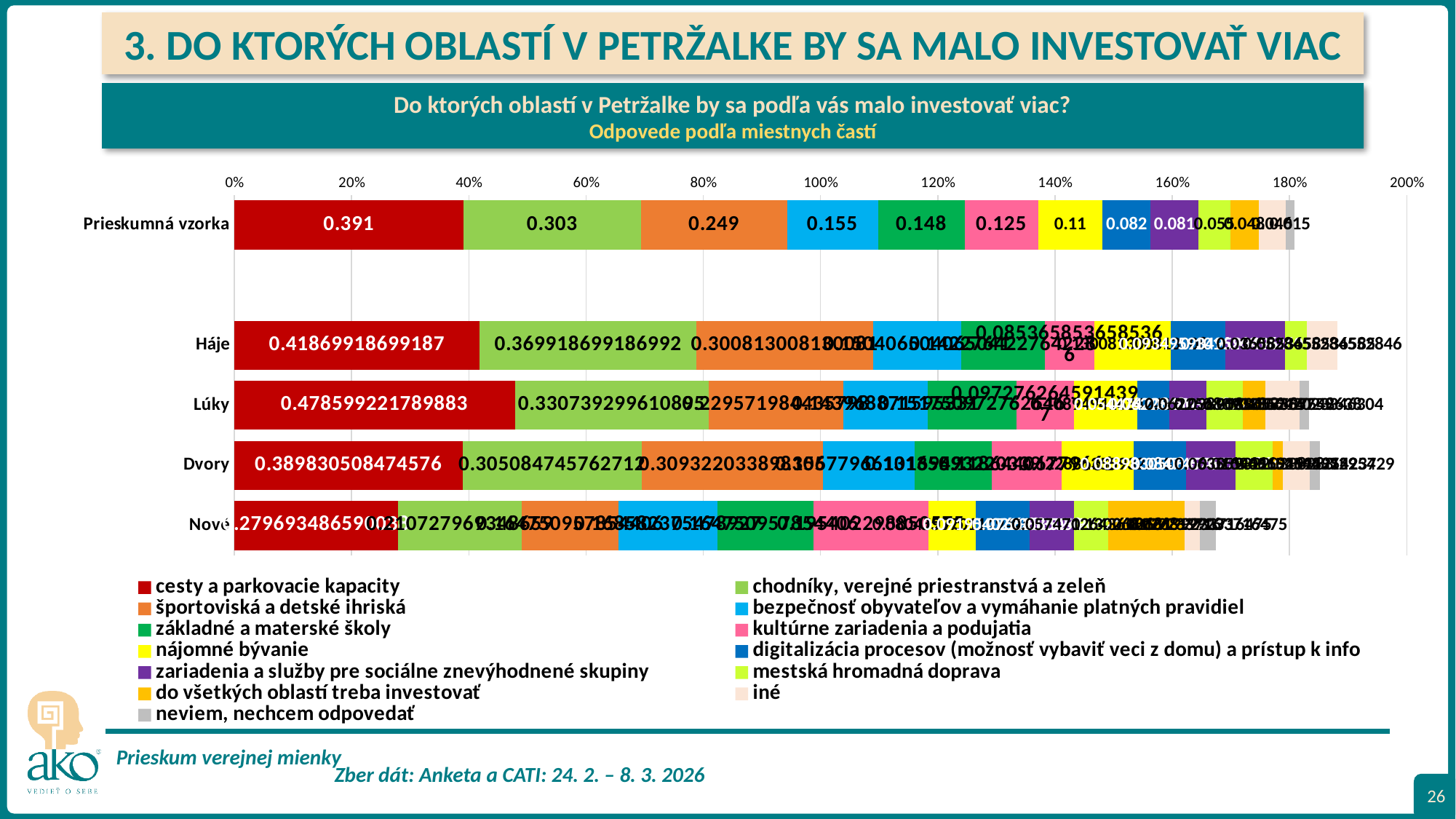
What is the value for 'cesty a parkovacie kapacity' in the 'Lúky' bar? 0.478599221789883 What is the value for 'športoviská a detské ihriská' in the 'Prieskumná vzorka' bar? 0.249 What is the value for 'cesty a parkovacie kapacity' in the 'Prieskumná vzorka' bar? 0.391 How many bars (categories) are plotted on the chart? 5 What is the value for 'nájomné bývanie' in the 'Prieskumná vzorka' bar? 0.11 What is the value for 'chodníky, verejné priestranstvá a zeleň' in the 'Prieskumná vzorka' bar? 0.303 What is the difference between 'cesty a parkovacie kapacity' and 'chodníky, verejné priestranstvá a zeleň' in the 'Prieskumná vzorka' bar? 0.088 What is the value for 'cesty a parkovacie kapacity' in the 'Háje' bar? 0.41869918699187 What kind of chart is shown on the slide? bar chart Which colour represents 'cesty a parkovacie kapacity' in the legend? red Which local part has the highest value for 'cesty a parkovacie kapacity'? Lúky How many series does the legend list? 13